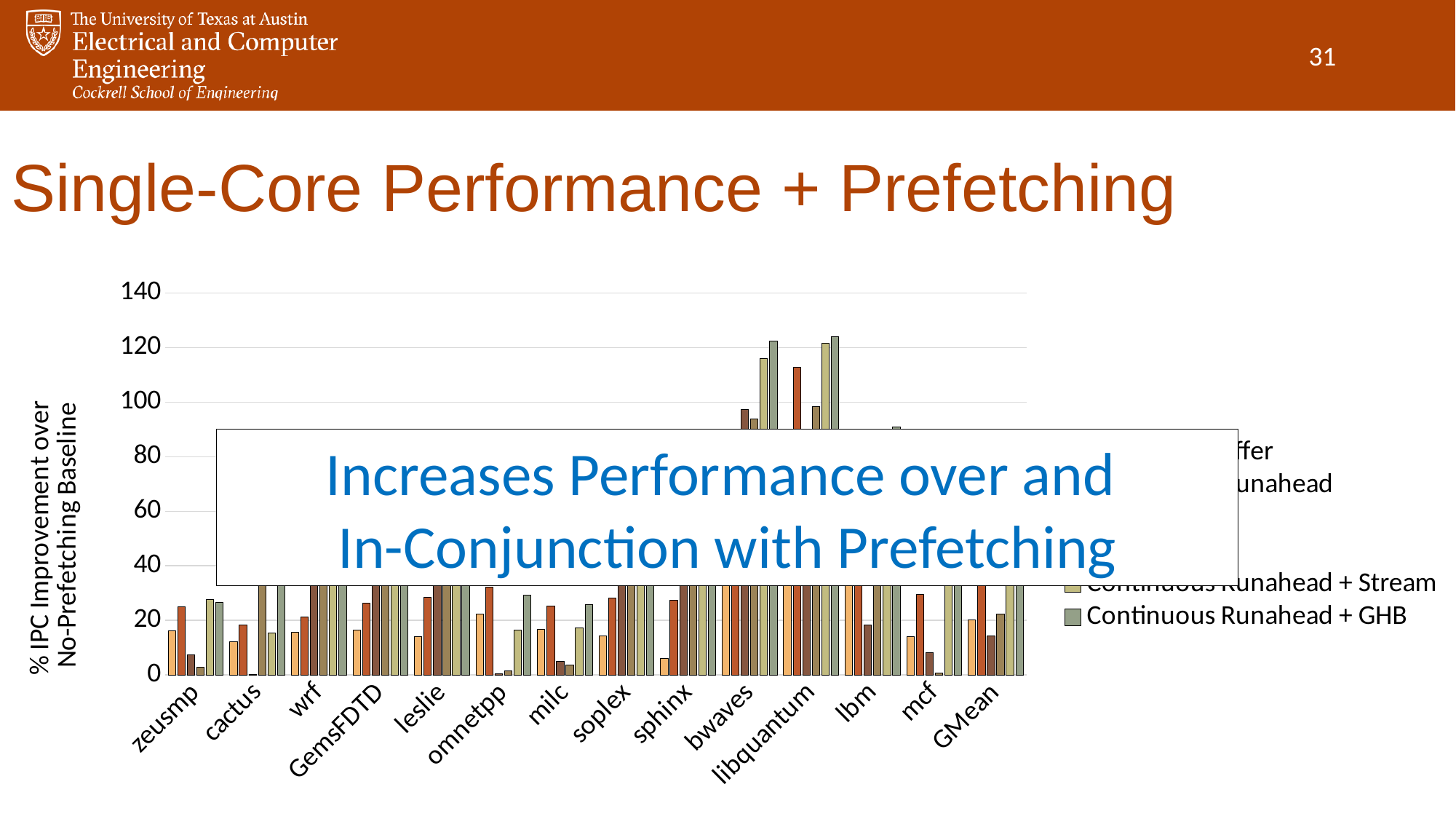
For omnetpp, which is larger: the Continuous Runahead + Stream bar or the Continuous Runahead + GHB bar? Continuous Runahead + GHB What is the title of the slide containing the chart? Single-Core Performance + Prefetching How many benchmark categories are shown along the x axis of the chart? 14 Is the value of the Continuous Runahead + GHB bar for omnetpp greater or less than 20? greater Is the value of the Continuous Runahead + GHB bar for milc greater or less than 20? greater What kind of chart is shown on the slide? bar chart For milc, which is larger: the Continuous Runahead + Stream bar or the Continuous Runahead + GHB bar? Continuous Runahead + GHB Is the tallest bar for bwaves greater or less than 100? greater What is the label of the y axis of the chart? % IPC Improvement over No-Prefetching Baseline